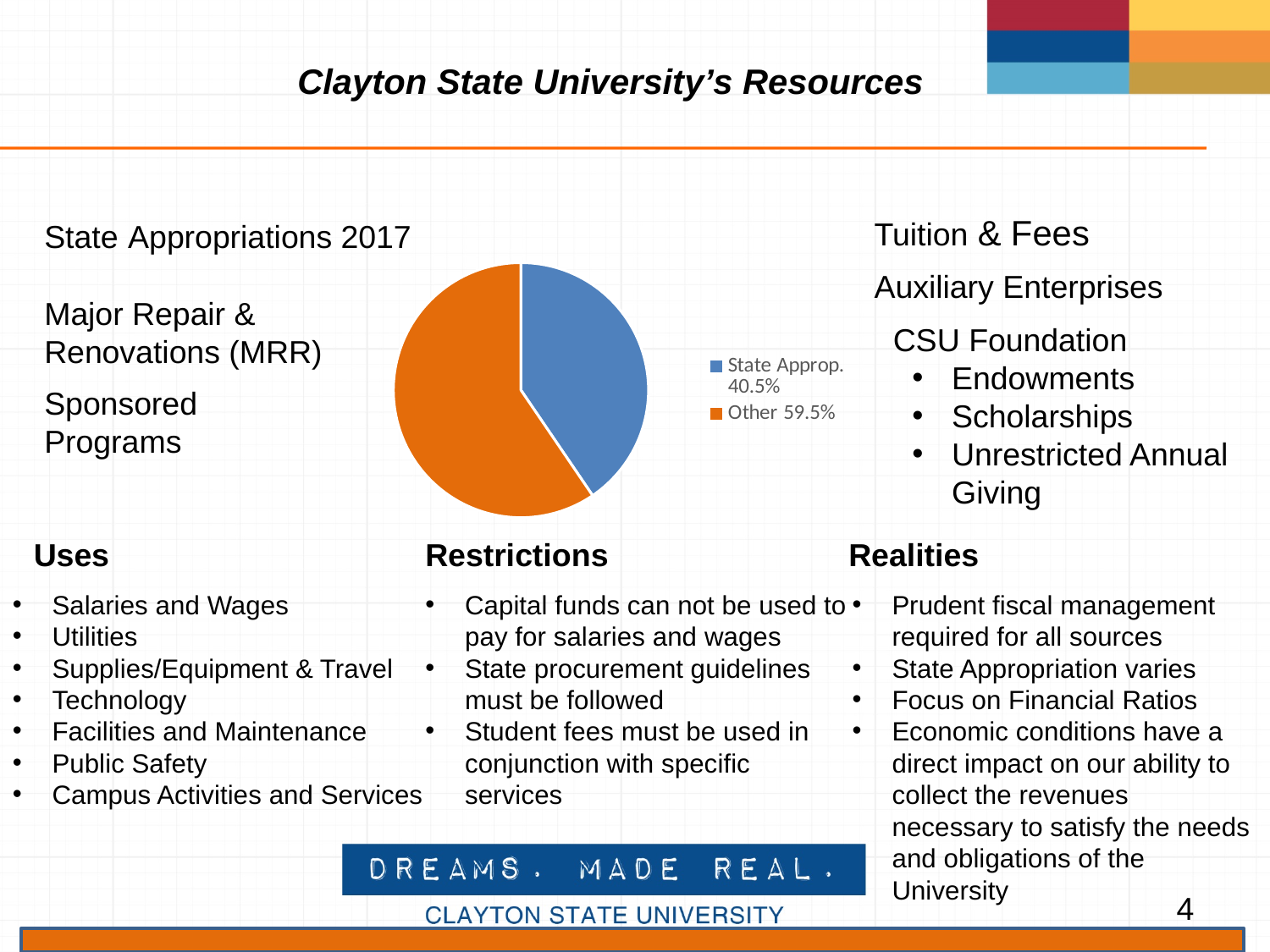
Which slice of the pie chart is the smallest? State Approp. Which slice of the pie chart is the largest? Other How many entries does the pie chart's legend list? 2 What share of the pie does State Approp. represent? 40.5% What colour is the Other slice in the pie chart? orange What kind of chart is shown on the slide? pie chart Which is larger in the pie chart, State Approp. or Other? Other What colour is the State Approp. slice in the pie chart? blue What share of the pie does Other represent? 59.5% How many slices does the pie chart have? 2 What is the difference in percentage points between the Other slice and the State Approp. slice? 19 percentage points